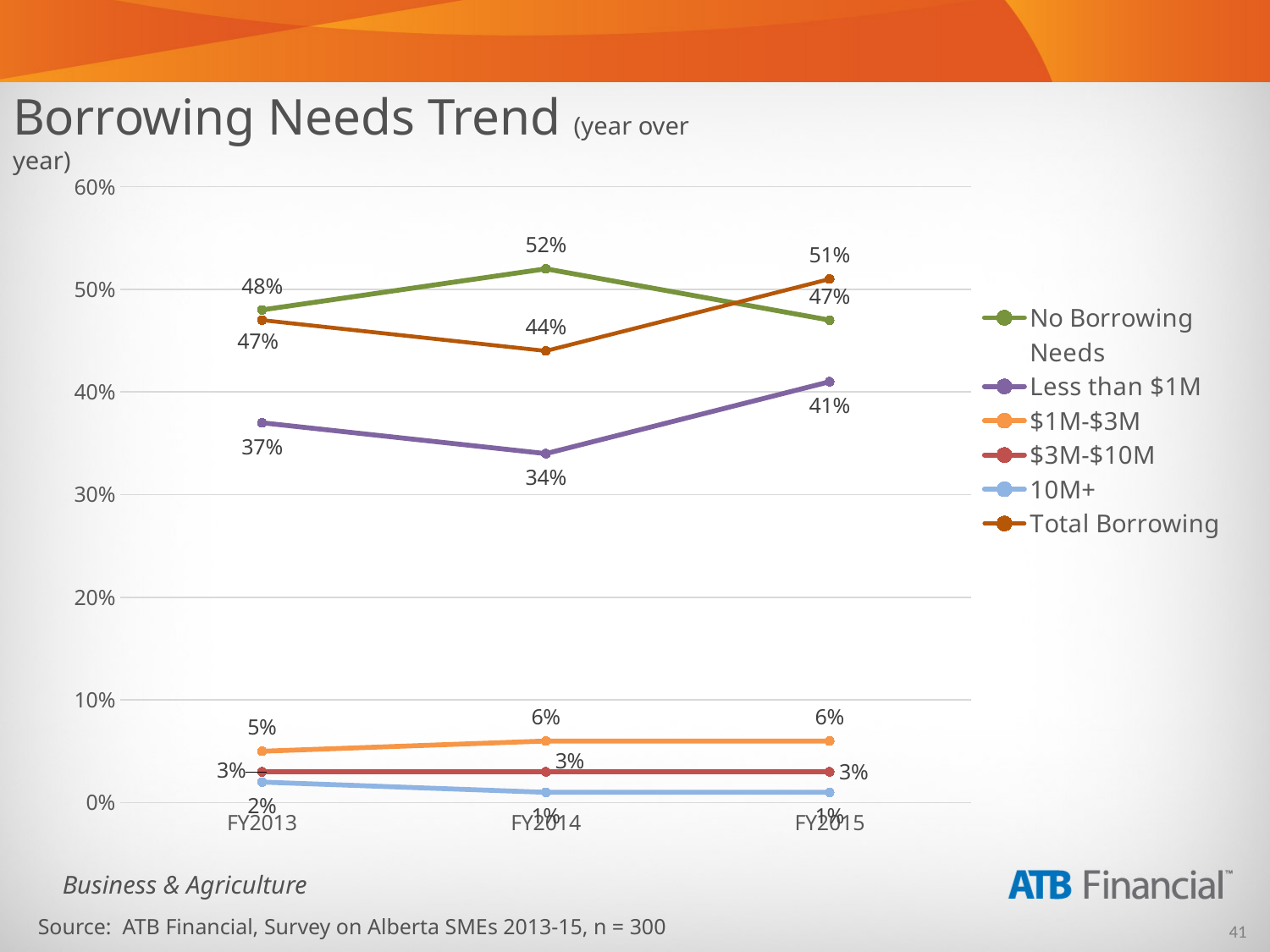
Does the Less than $1M series rise or fall from FY2014 to FY2015? rise What is the value for Less than $1M in FY2014? 34% How many series does the legend list? 6 What is the difference between No Borrowing Needs and Total Borrowing in FY2014? 8% What kind of chart is shown on the slide? line chart Which is larger in FY2015, No Borrowing Needs or Total Borrowing? Total Borrowing What is the value for Total Borrowing in FY2015? 51% How many fiscal years are plotted along the x axis? 3 In which fiscal year is the Less than $1M series highest? FY2015 In which fiscal year is the Total Borrowing series lowest? FY2014 What is the value for $1M-$3M in FY2013? 5% What is the value for No Borrowing Needs in FY2014? 52%